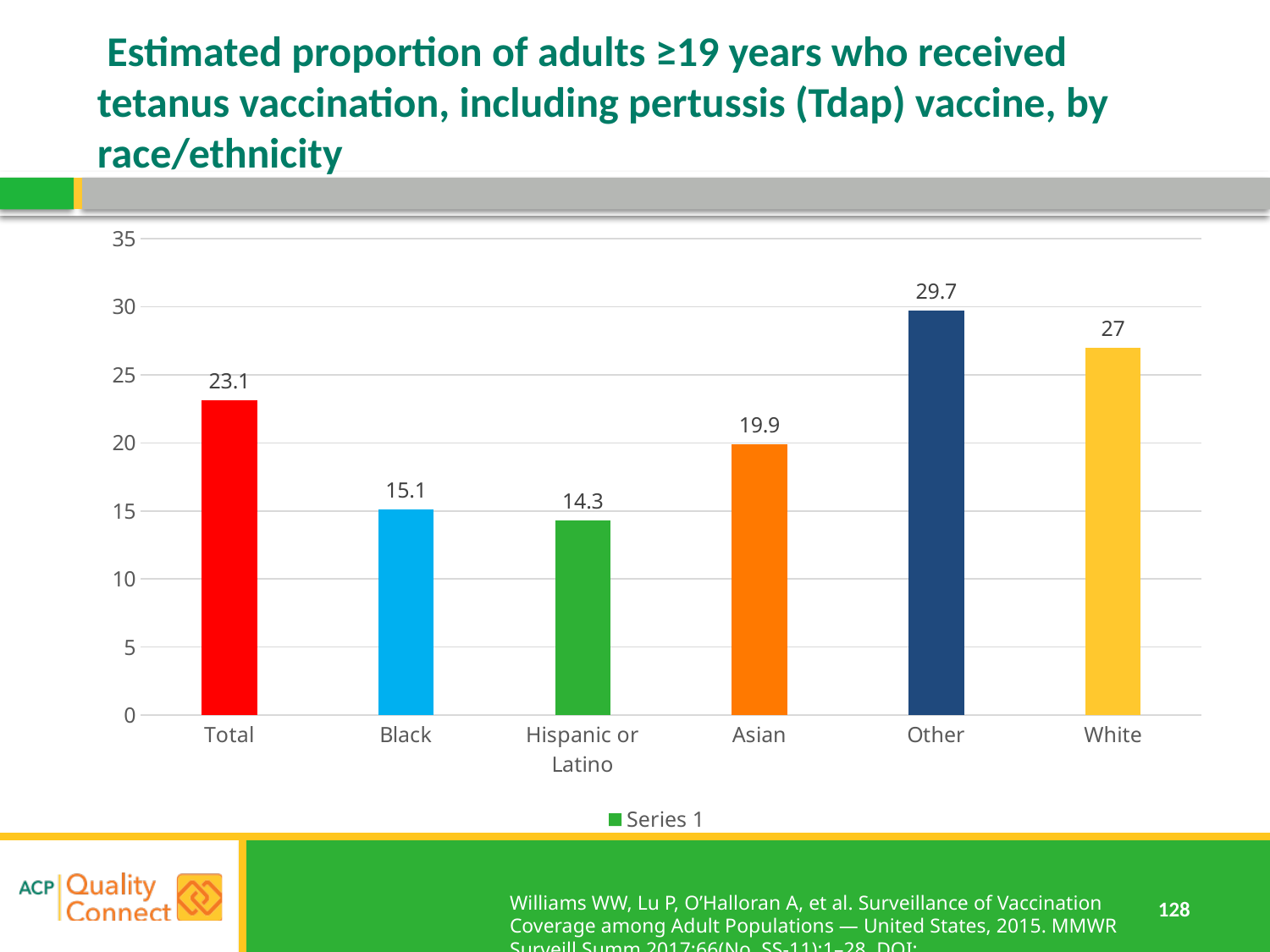
What is the difference between the values for Black and Hispanic or Latino? 0.8 What is the value for White? 27 What kind of chart is shown on the slide? bar chart Which category has the lowest value? Hispanic or Latino What series name does the legend show? Series 1 What is the value for Total? 23.1 How many categories are shown on the x axis? 6 What is the value for Asian? 19.9 What is the difference between the values for Other and White? 2.7 Which is larger, the value for Total or the value for Asian? Total Which category has the highest value? Other Is the value for Black greater or less than 20? less